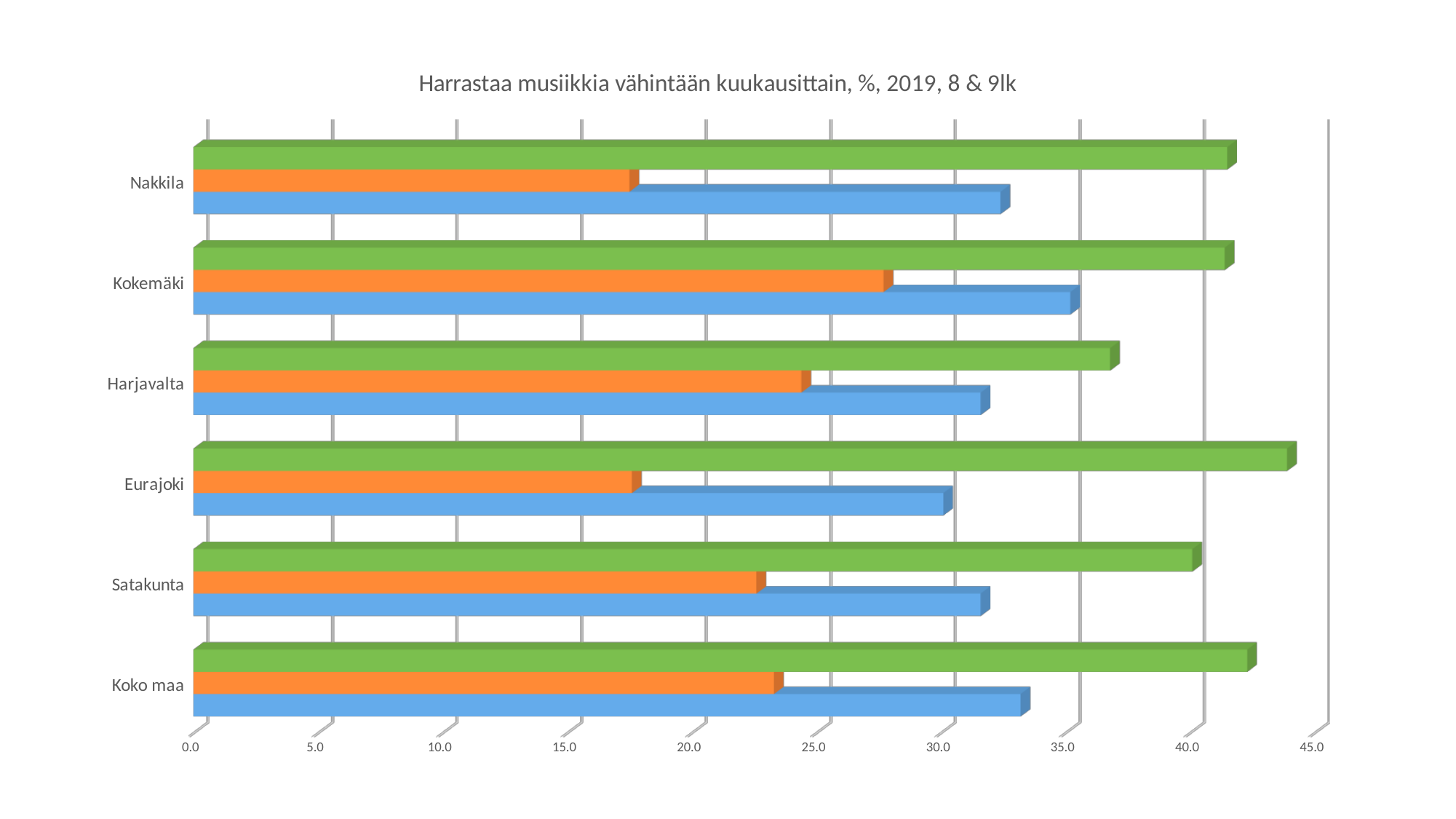
Is the green bar for Harjavalta greater or less than 40.0? less Which category has the shortest green bar? Harjavalta What kind of chart is shown on the slide? bar chart What is the title of the chart? Harrastaa musiikkia vähintään kuukausittain, %, 2019, 8 & 9lk How many bars are shown for each category in the chart? 3 Which category has the longest orange bar? Kokemäki Which category has the longest blue bar? Kokemäki How many categories are shown on the vertical axis of the chart? 6 Which category has the longest green bar? Eurajoki Is the green bar for Eurajoki greater or less than 40.0? greater Is the orange bar for Nakkila greater or less than 20.0? less Which is larger, the orange bar for Kokemäki or the orange bar for Nakkila? Kokemäki